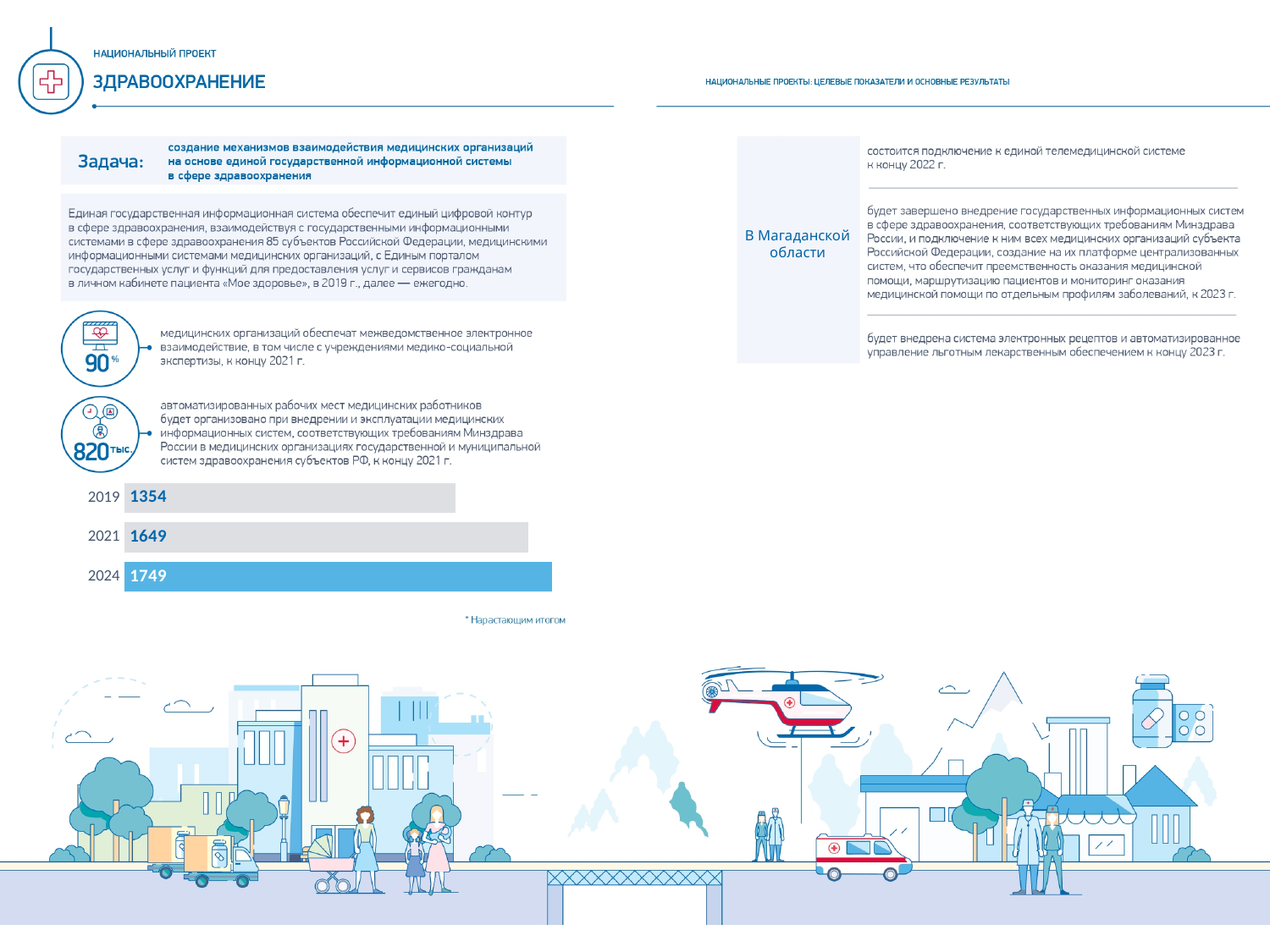
What is the value shown for 2021 in the bar chart? 1649 How many years (bars) are shown in the bar chart? 3 What is the value shown for 2024 in the bar chart? 1749 What is the difference between the values for 2021 and 2019 in the bar chart? 295 What is the value shown for 2019 in the bar chart? 1354 Which year has the lowest value in the bar chart? 2019 Do the values in the bar chart rise or fall from 2019 to 2024? rise What is the difference between the values for 2024 and 2019 in the bar chart? 395 Which is larger in the bar chart, the value for 2021 or the value for 2024? 2024 Which bar in the chart is coloured blue rather than grey? 2024 What kind of chart is shown on the slide? bar chart Which year has the highest value in the bar chart? 2024